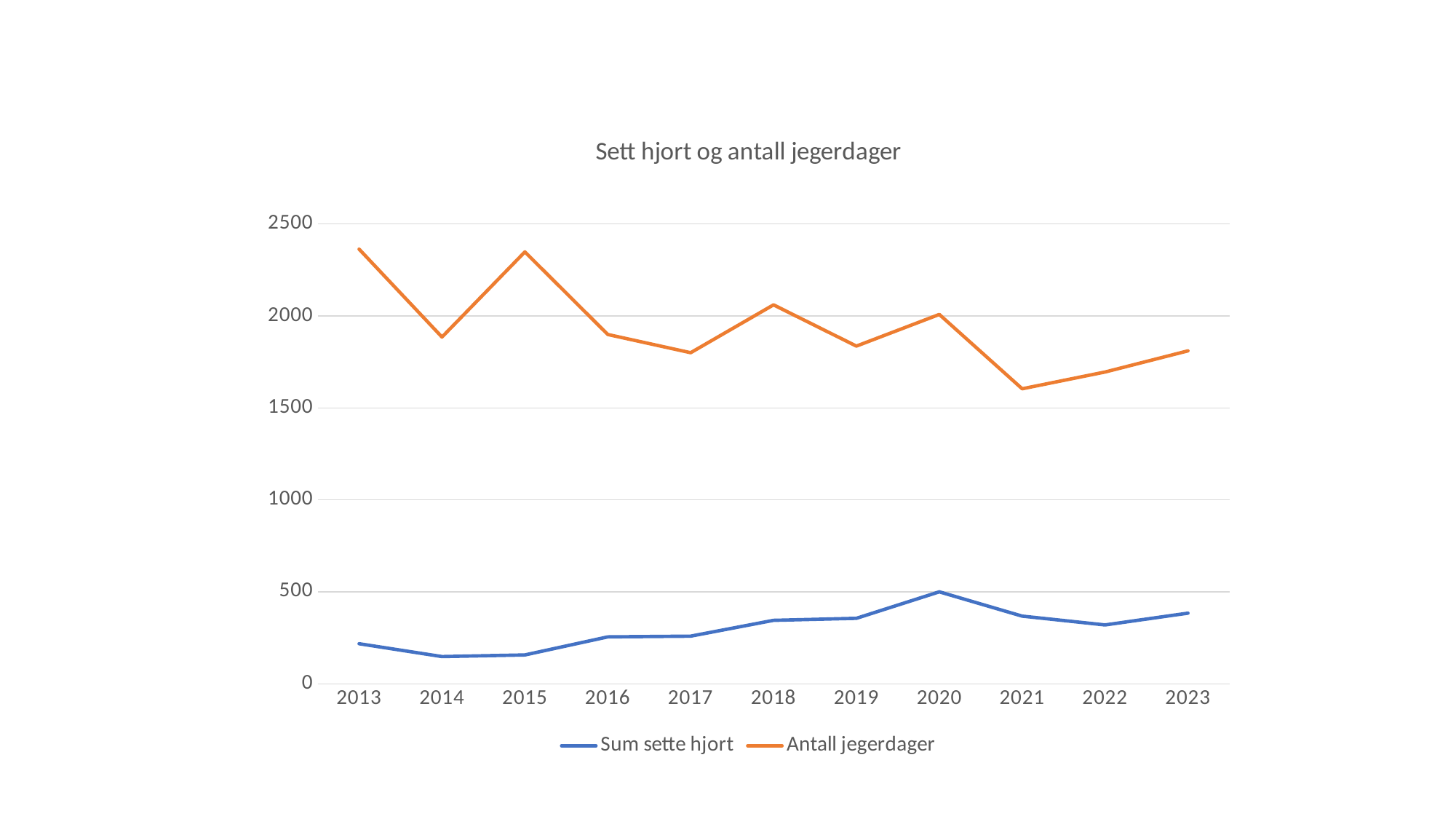
Is the value for Sum sette hjort in 2014 greater or less than 500? less In which year is Antall jegerdager lowest? 2021 What kind of chart is shown on the slide? line chart In which year is Sum sette hjort highest? 2020 Is the value for Antall jegerdager in 2017 greater or less than 2000? less What is the title of the chart? Sett hjort og antall jegerdager Which is larger for Antall jegerdager: the value in 2018 or the value in 2019? 2018 How many series does the legend list? 2 Does Antall jegerdager rise or fall overall from 2013 to 2023? fall Is the value for Antall jegerdager in 2013 greater or less than 2000? greater Which series is drawn in orange? Antall jegerdager How many years are shown on the x axis? 11